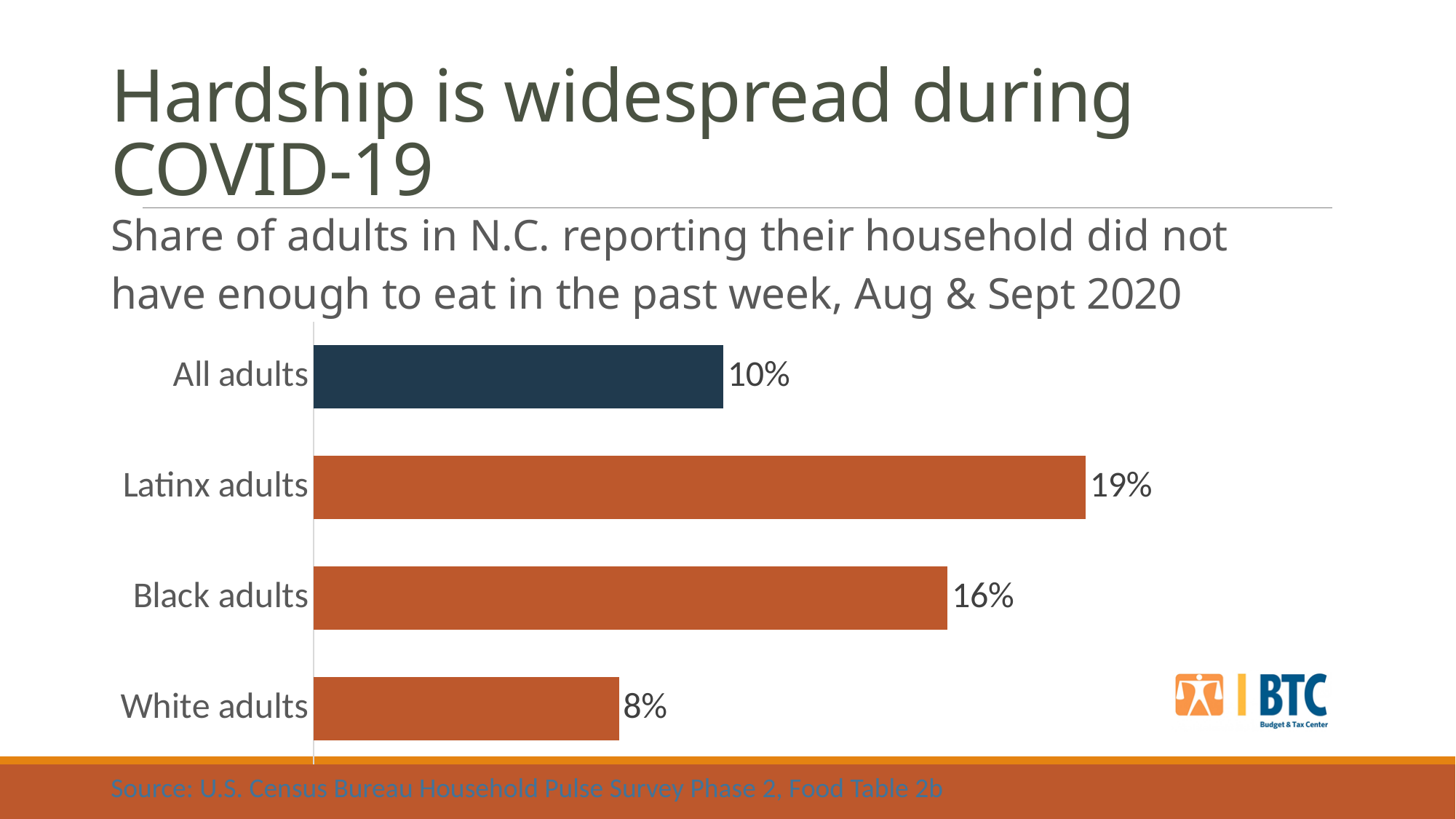
What is the value shown for Black adults? 16% Which group has the lowest share reporting not enough to eat? White adults How many categories are shown in the chart? 4 Which group has the highest share reporting not enough to eat? Latinx adults What is the value shown for Latinx adults? 19% What is the difference in percentage points between Black adults and All adults? 6 percentage points What is the value shown for White adults? 8% What kind of chart is shown on the slide? Bar chart What is the difference in percentage points between Latinx adults and White adults? 11 percentage points Which is larger, the value for Black adults or the value for Latinx adults? Latinx adults Which bar is shown in a different colour (dark blue) from the others? All adults What share of all adults in N.C. reported their household did not have enough to eat in the past week? 10%